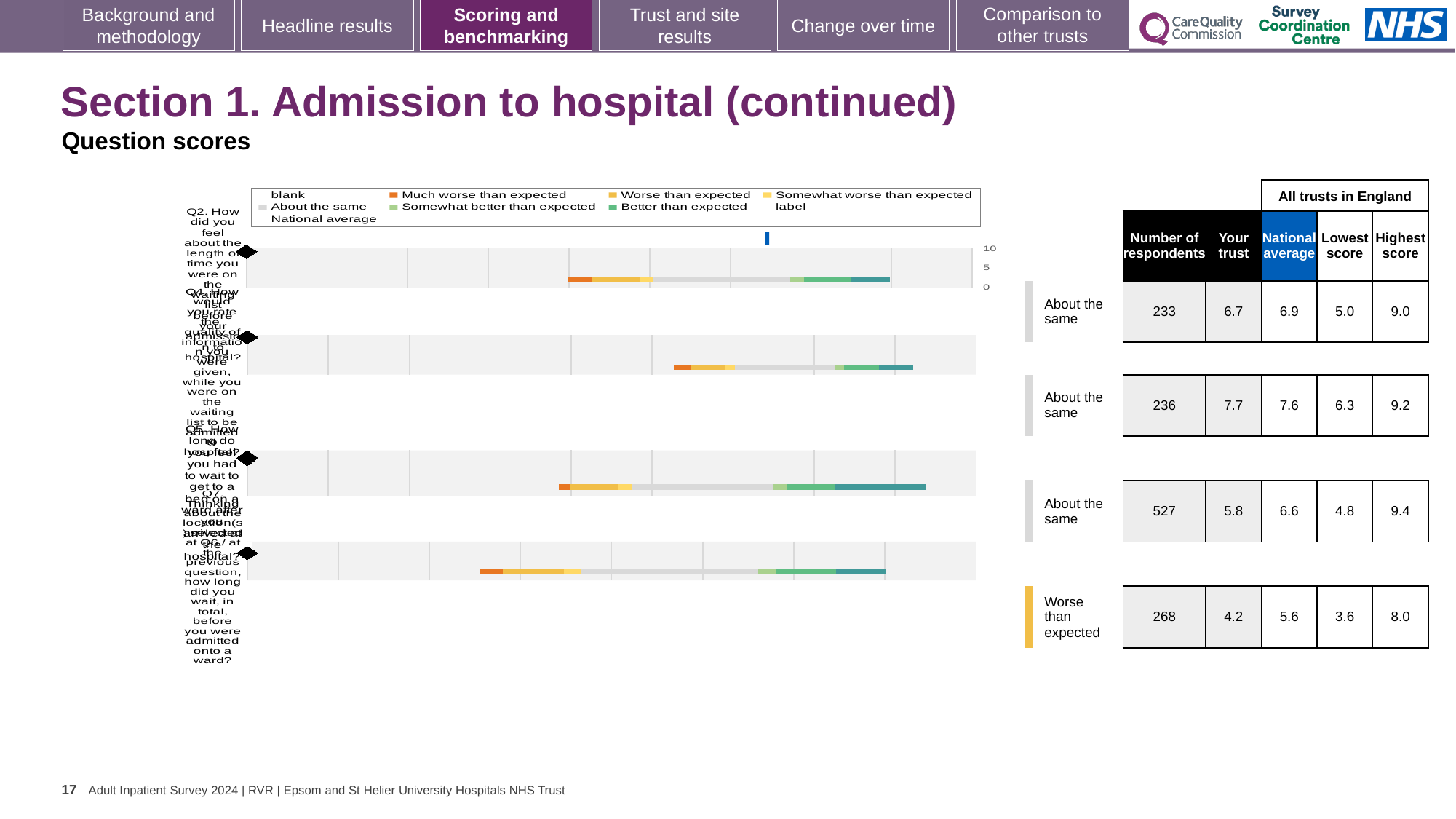
In the table, what is the highest score for the row with 268 respondents? 8.0 In the table, what is the 'Your trust' score for the row with 527 respondents? 5.8 In the table, for the row with 236 respondents, which is larger: the 'Your trust' score or the national average? Your trust In the table, what is the highest 'Your trust' score across the four rows? 7.7 How many horizontal bars are plotted in the chart? 4 In the table, what is the number of respondents for the first row? 233 What kind of chart is shown on the left of the slide? bar chart What colour does the legend use for 'Much worse than expected'? orange In the table, what is the lowest 'Your trust' score across the four rows? 4.2 How many of the four rows are rated 'Worse than expected'? 1 What is the highest tick value shown on the chart's axis? 10 In the table, for the row with 268 respondents, how much higher is the national average than the 'Your trust' score? 1.4